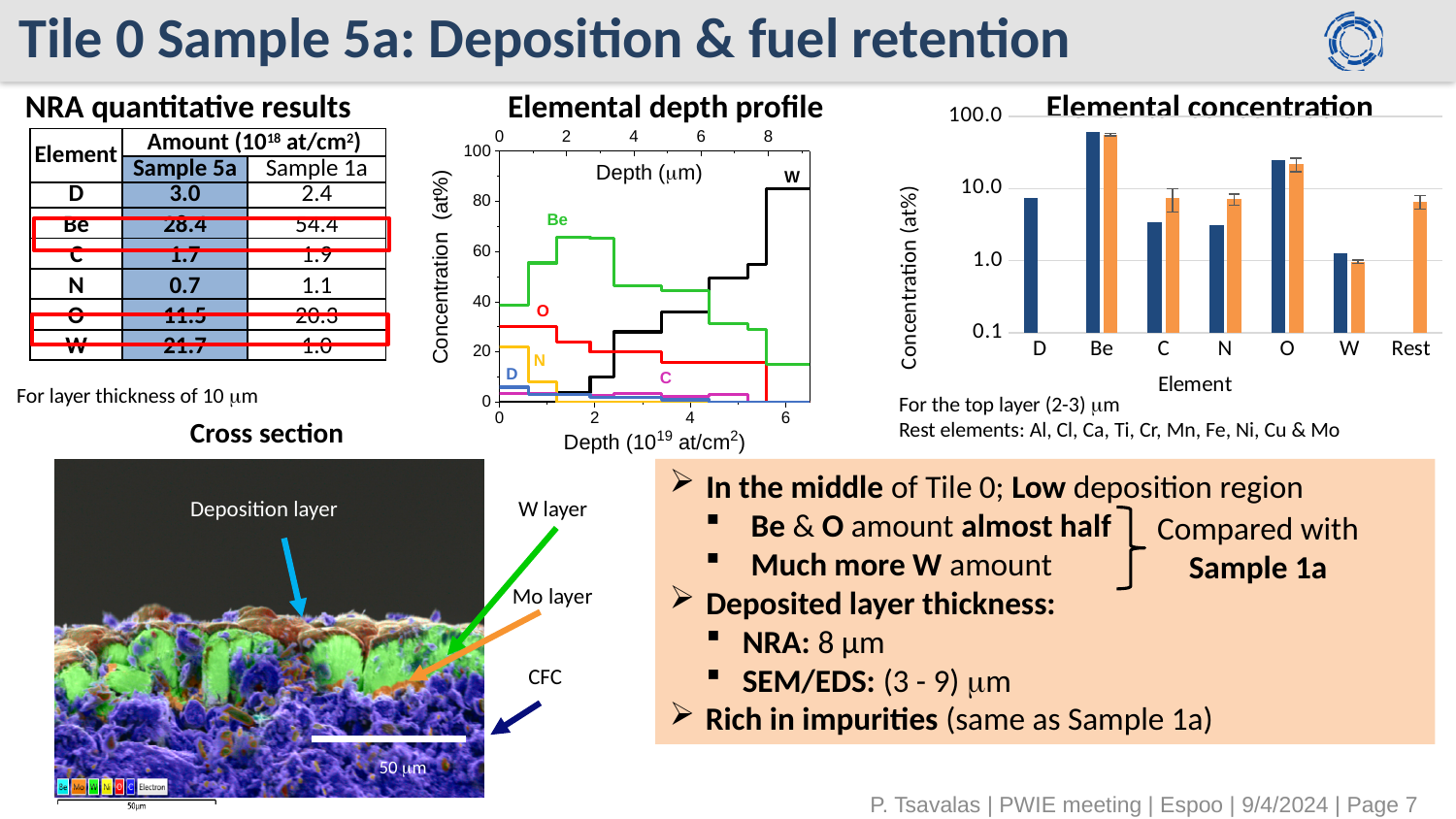
In the 'Elemental concentration' chart, which element has the highest concentration? Be What kind of chart is the 'Elemental concentration' chart? bar chart In the 'Elemental concentration' chart, is the blue bar for D greater or less than 10.0 at%? less What is the y-axis label of the 'Elemental concentration' chart? Concentration (at%) In the 'Elemental depth profile' chart, does the W concentration rise or fall as depth increases? rise In the 'Elemental concentration' chart, how many elements are shown on the x axis? 7 In the 'Elemental depth profile' chart, how many elements are labelled on the curves? 6 In the 'Elemental concentration' chart, which has the higher concentration, O or C? O In the 'Elemental concentration' chart, is the blue bar for C greater or less than 1.0 at%? greater In the 'Elemental concentration' chart, is the blue bar for Be greater or less than 10.0 at%? greater In the 'Elemental concentration' chart, which element has the lowest concentration among the blue bars? W What kind of chart is the 'Elemental depth profile' chart? line chart